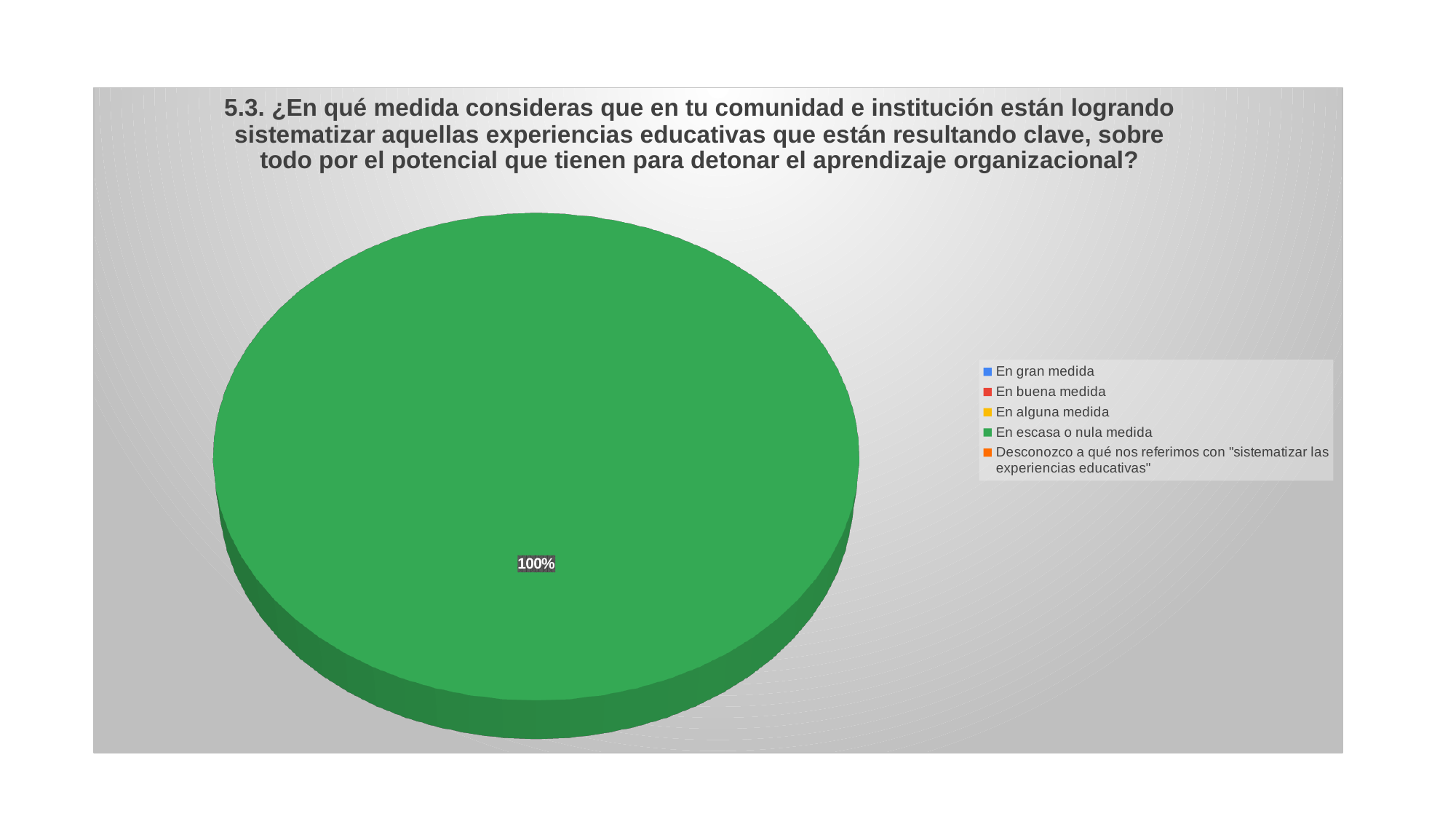
What is the value printed as the data label on the pie? 100% Is the share for "En escasa o nula medida" greater or less than 50%? greater What share of the pie does "En escasa o nula medida" represent? 100% What colour is the slice labelled 100%? green Which legend entry is shown in green? En escasa o nula medida What kind of chart is shown on the slide? pie chart How many entries does the legend list? 5 How many slices are visible in the pie? 1 Which category accounts for the largest share of the pie? En escasa o nula medida